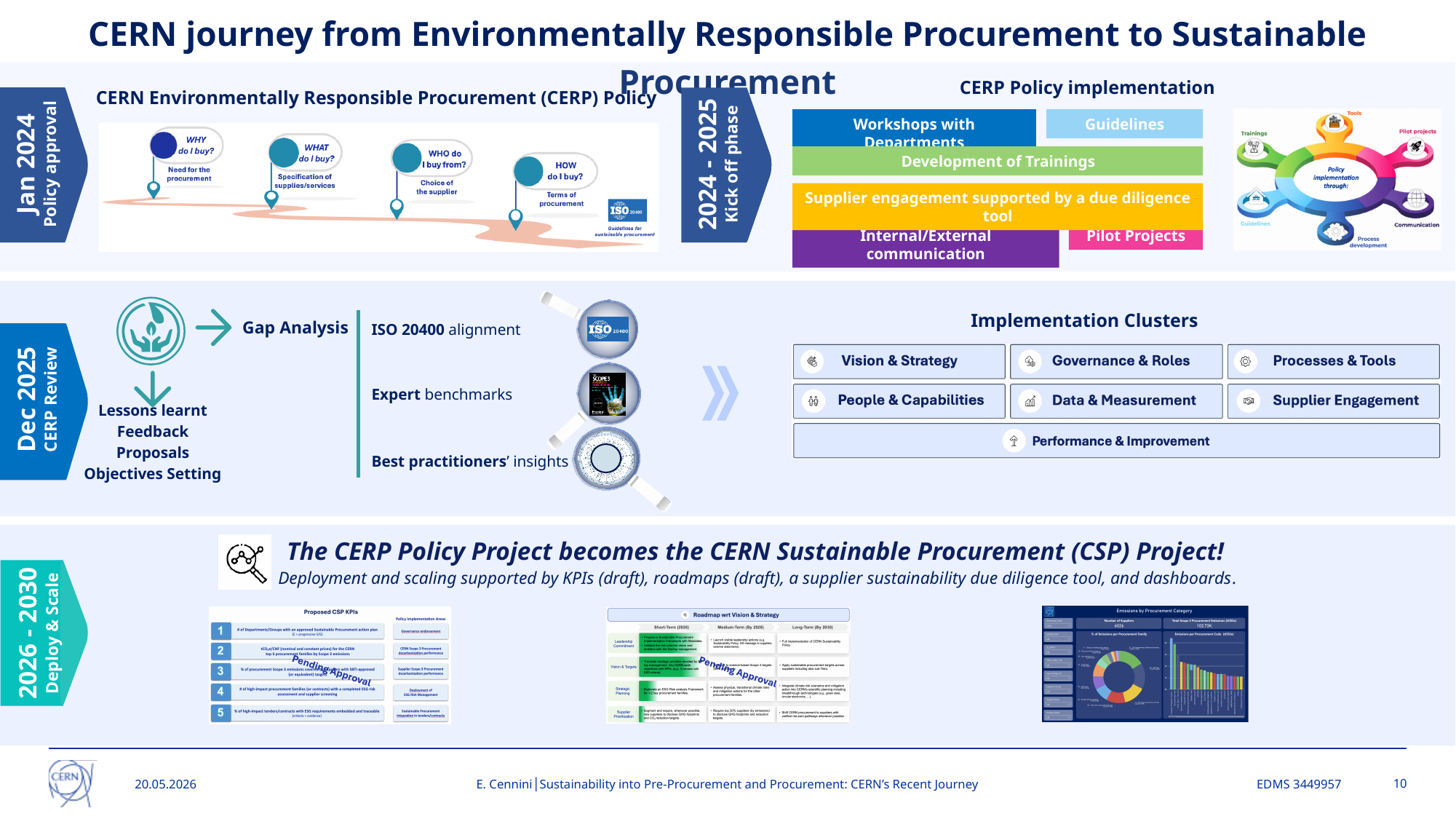
In the dashboard at the bottom right of the slide, what kind of chart is shown on the right side? Bar chart In the 'Emissions by Procurement Category' dashboard, which chart is on the left: the bar chart or the donut chart? Donut chart In the bar chart of the 'Emissions by Procurement Category' dashboard, do the bar values rise or fall from left to right? Fall What is the title of the dashboard shown at the bottom right of the slide? Emissions by Procurement Category In the dashboard at the bottom right of the slide, what kind of chart is shown on the left side? Pie chart (donut) How many charts are shown in the 'Emissions by Procurement Category' dashboard at the bottom right of the slide? 2